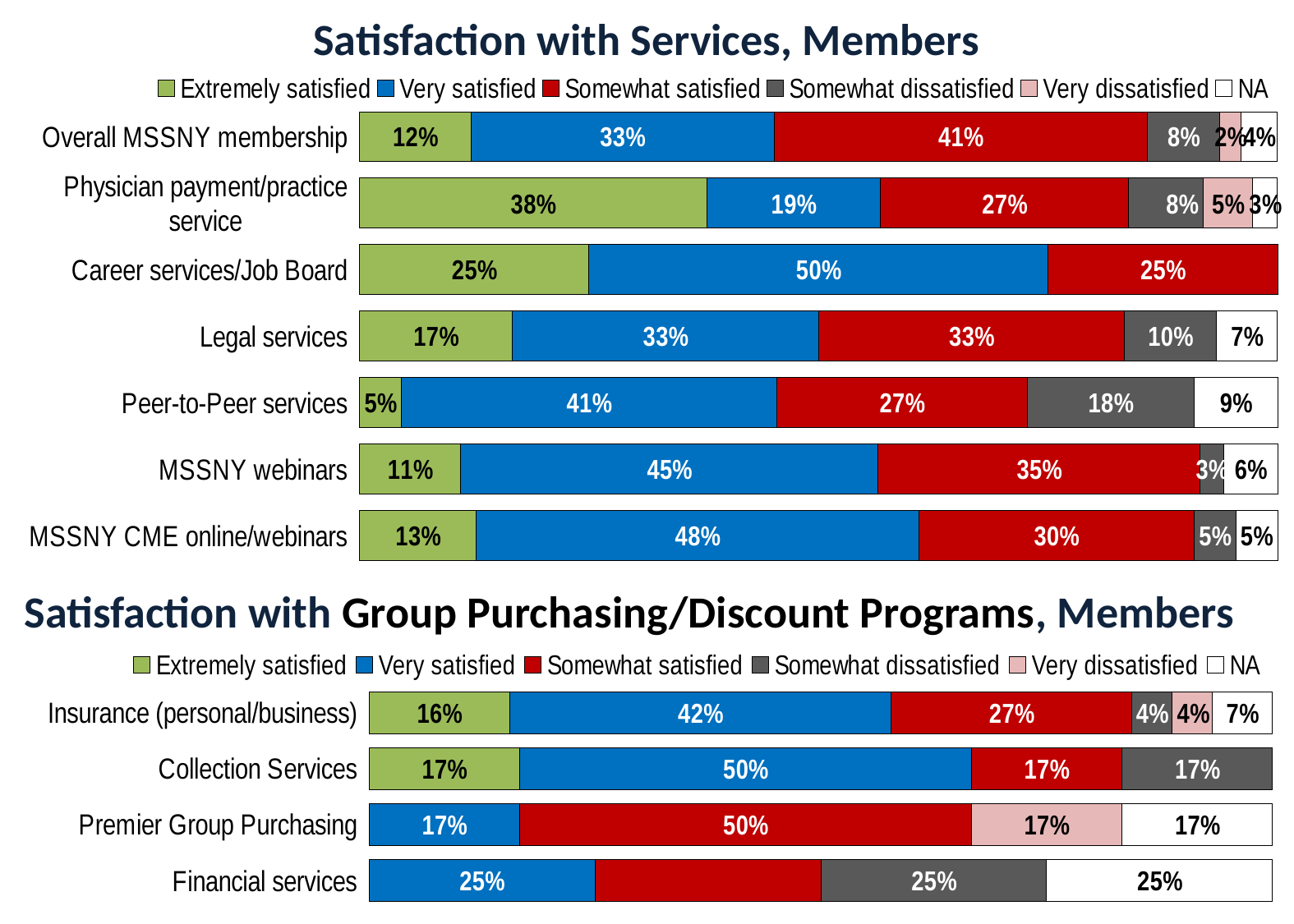
In the 'Satisfaction with Group Purchasing/Discount Programs, Members' chart, which colour represents Somewhat satisfied? Red In the 'Satisfaction with Services, Members' chart, what percentage of members were Extremely satisfied with Physician payment/practice service? 38% In the 'Satisfaction with Group Purchasing/Discount Programs, Members' chart, what is the Very satisfied value for Insurance (personal/business)? 42% How many service categories are shown in the 'Satisfaction with Services, Members' chart? 7 In the 'Satisfaction with Services, Members' chart, which category has the highest Extremely satisfied percentage? Physician payment/practice service In the 'Satisfaction with Services, Members' chart, what is the Very satisfied value for Career services/Job Board? 50% In the 'Satisfaction with Services, Members' chart, which is larger: the Somewhat dissatisfied value for Peer-to-Peer services or for Legal services? Peer-to-Peer services In the 'Satisfaction with Services, Members' chart, what is the difference between the Somewhat satisfied values for Overall MSSNY membership and MSSNY CME online/webinars? 11% In the 'Satisfaction with Services, Members' chart, which category has the lowest Extremely satisfied percentage? Peer-to-Peer services How many series does the legend of the 'Satisfaction with Group Purchasing/Discount Programs, Members' chart list? 6 What kind of chart is the 'Satisfaction with Group Purchasing/Discount Programs, Members' chart? Stacked bar chart In the 'Satisfaction with Group Purchasing/Discount Programs, Members' chart, what is the NA value for Financial services? 25%